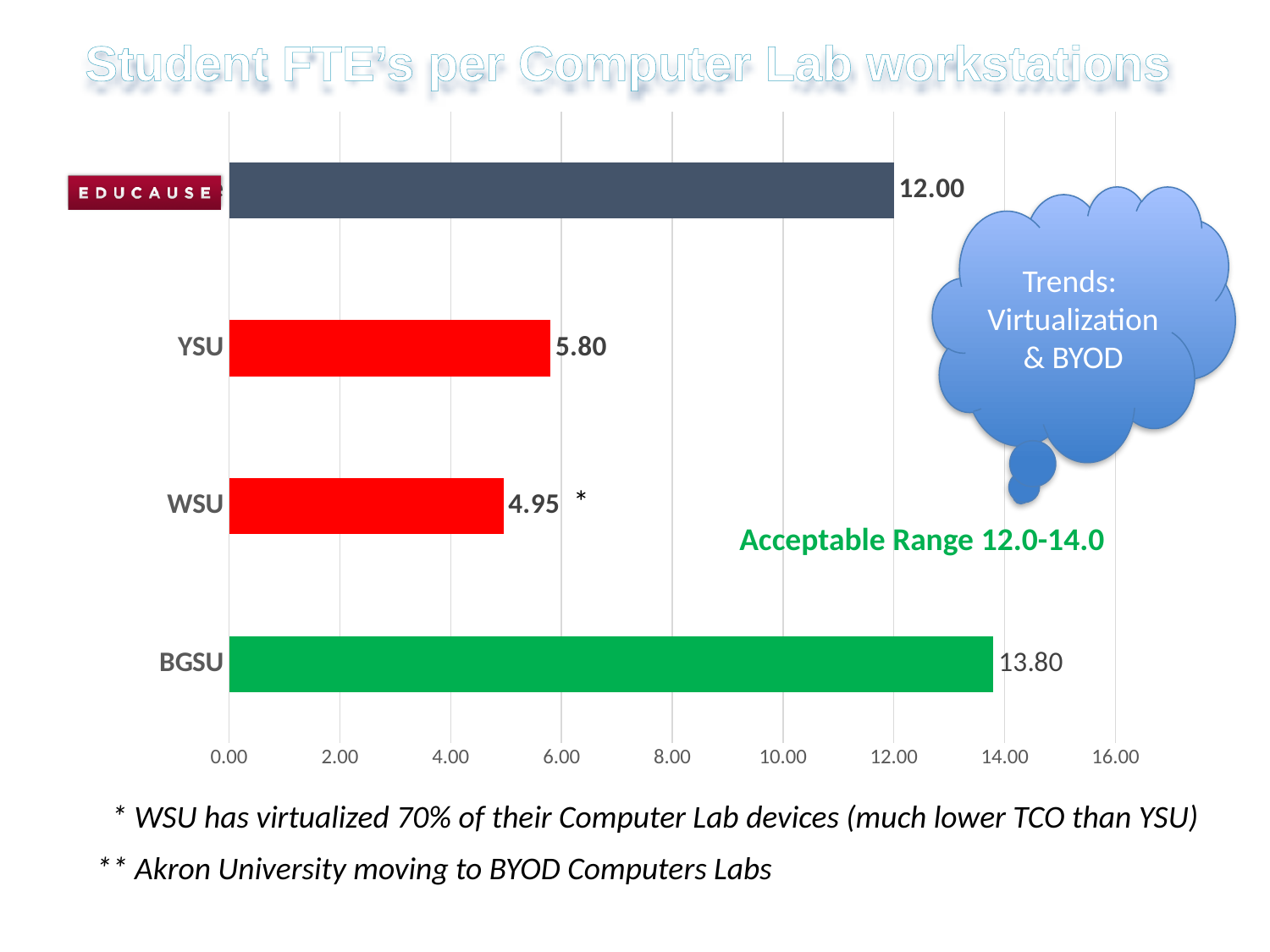
What is the value for BGSU? 13.80 What is the value for YSU? 5.80 What kind of chart is shown on the slide? Bar chart What is the value for WSU? 4.95 What is the title of the chart? Student FTE's per Computer Lab workstations Which category has the lowest value? WSU What is the value for the EDUCAUSE bar? 12.00 What is the difference between the YSU value and the WSU value? 0.85 What is the difference between the BGSU value and the EDUCAUSE value? 1.80 How many bars are shown in the chart? 4 Which is larger, the value for YSU or the value for WSU? YSU Which category has the highest value? BGSU